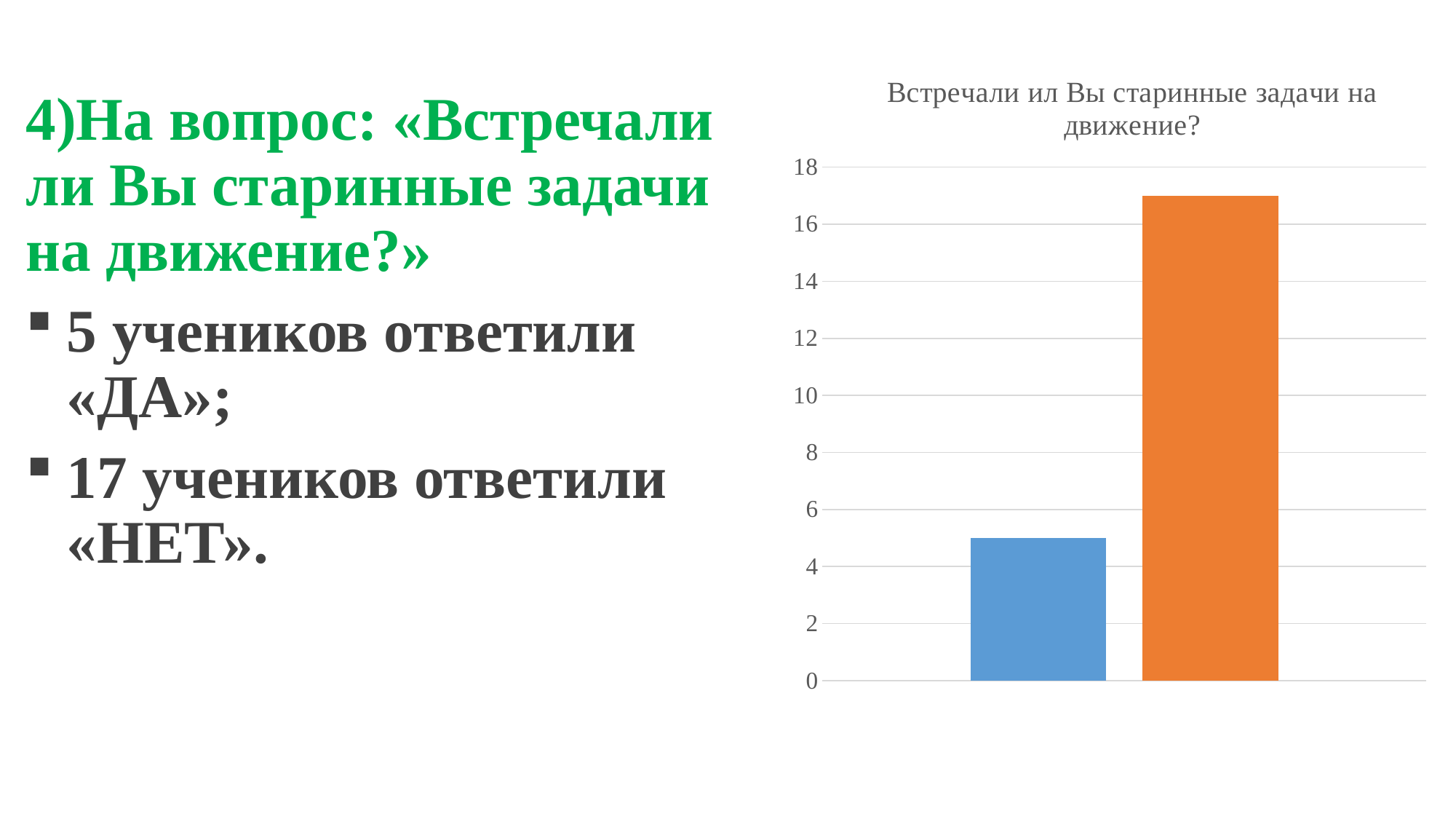
What is the title of the chart? Встречали ил Вы старинные задачи на движение? Is the value of the blue bar greater or less than 4? greater Is the value of the blue bar greater or less than 6? less How many bars does the chart contain? 2 Is the value of the orange bar greater or less than 18? less Which bar has the highest value? the orange (right) bar Do the bar values rise or fall from left to right? rise What kind of chart is shown on the slide? bar chart Which bar is taller, the blue one or the orange one? the orange one What is the highest value shown on the vertical axis? 18 Which bar has the lowest value? the blue (left) bar